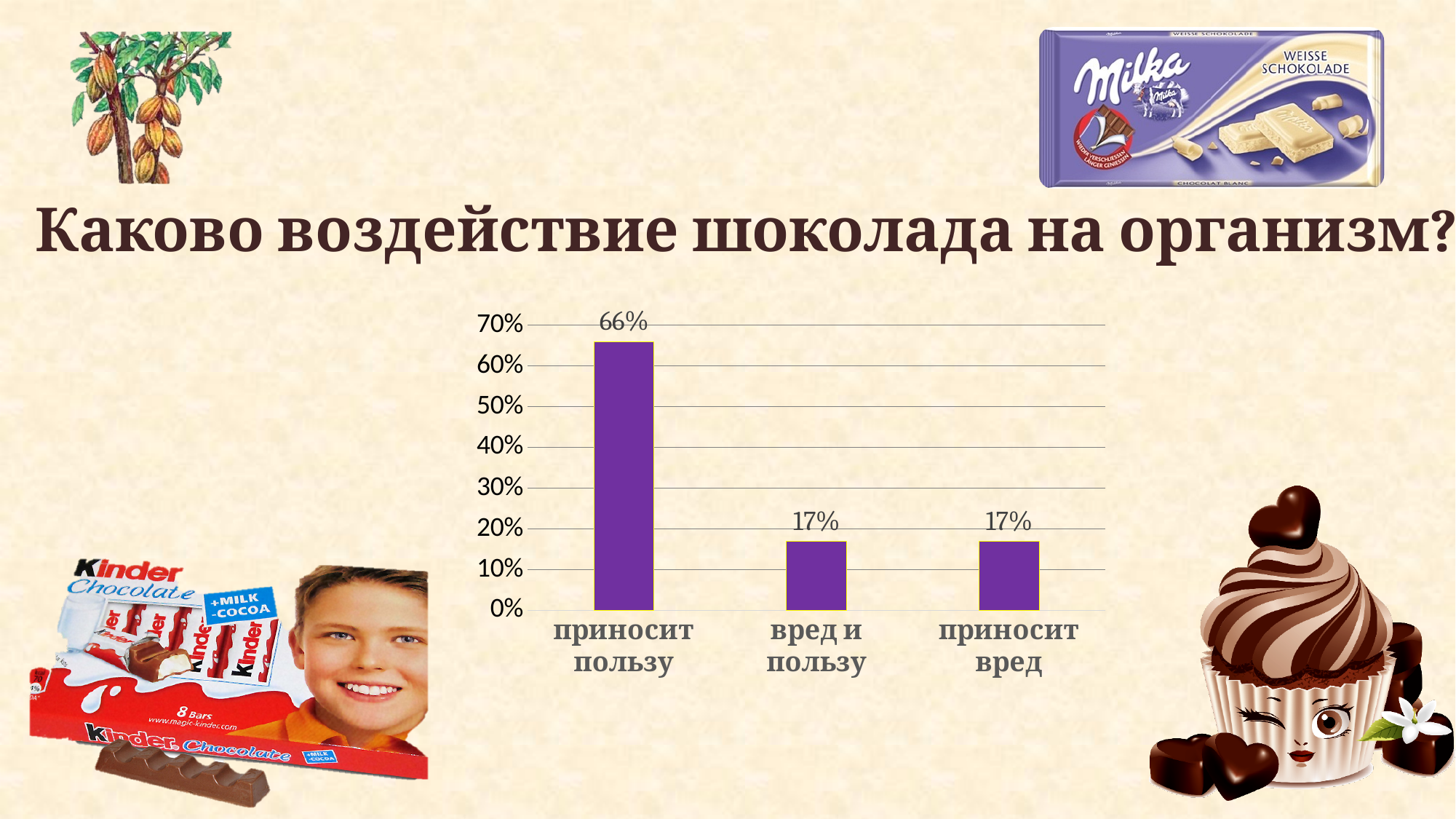
What is the total of the values for "вред и пользу" and "приносит вред"? 34% What colour are the bars in the chart? purple What kind of chart is shown on the slide? bar chart How many categories are shown on the chart? 3 Which is larger, the value for "приносит пользу" or the value for "вред и пользу"? приносит пользу What is the value for "приносит вред"? 17% Is the value for "вред и пользу" greater or less than 20%? less What is the value for "приносит пользу"? 66% What is the value for "вред и пользу"? 17% What is the difference between the values for "приносит пользу" and "приносит вред"? 49% Is the value for "приносит пользу" greater or less than 60%? greater Which category has the highest value? приносит пользу